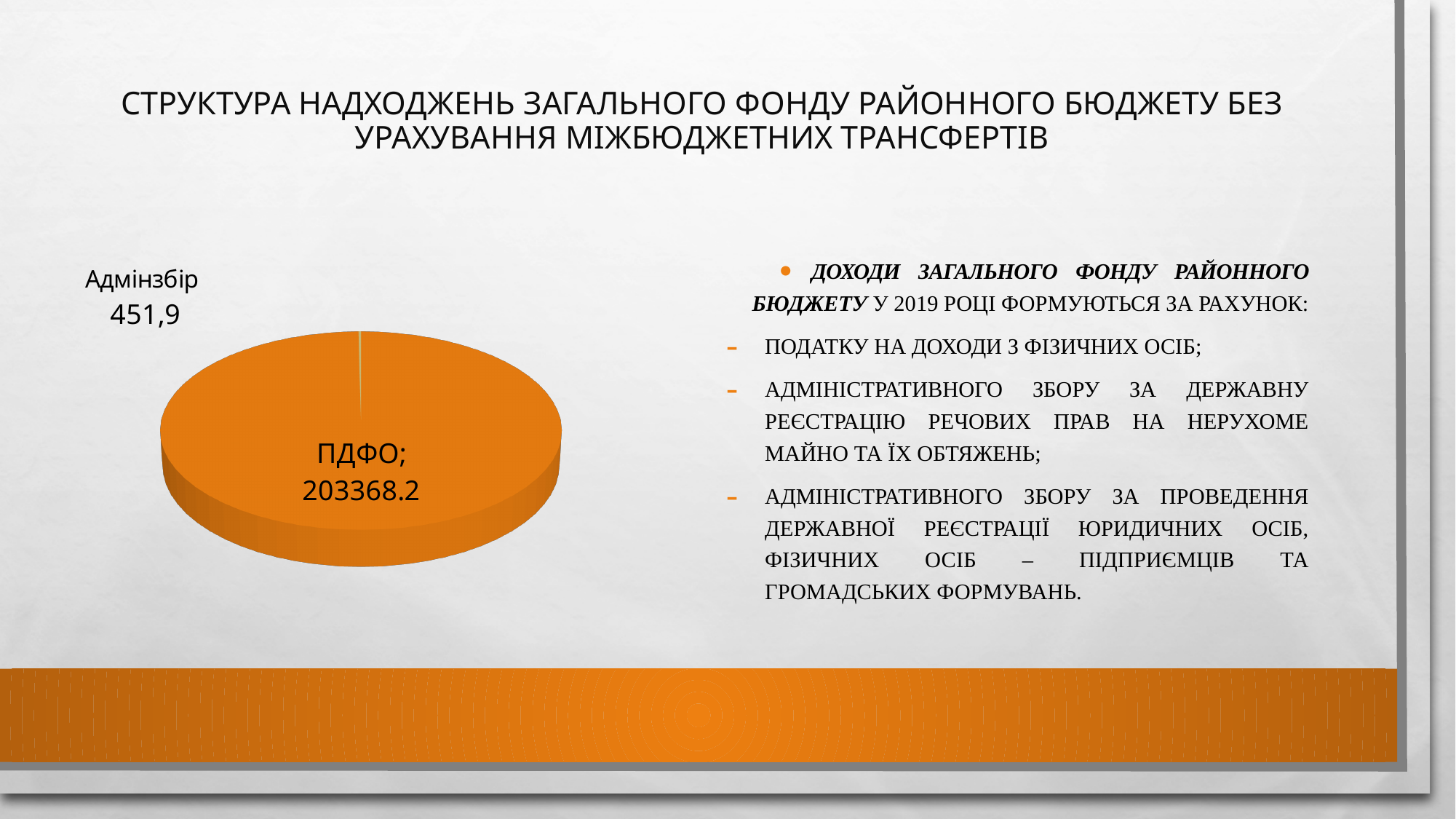
What is the total of the two values shown in the pie chart? 203820.1 Which is larger in the pie chart, ПДФО or Адмінзбір? ПДФО Which category has the largest slice in the pie chart? ПДФО What is the title of the slide containing the pie chart? Структура надходжень загального фонду районного бюджету без урахування міжбюджетних трансфертів What is the value shown for Адмінзбір in the pie chart? 451,9 What colour are the slices of the pie chart? orange What type of chart is shown on the slide? pie chart What is the value shown for ПДФО in the pie chart? 203368.2 What is the difference between the values for ПДФО and Адмінзбір? 202916.3 Which category has the smallest slice in the pie chart? Адмінзбір How many categories are shown in the pie chart? 2